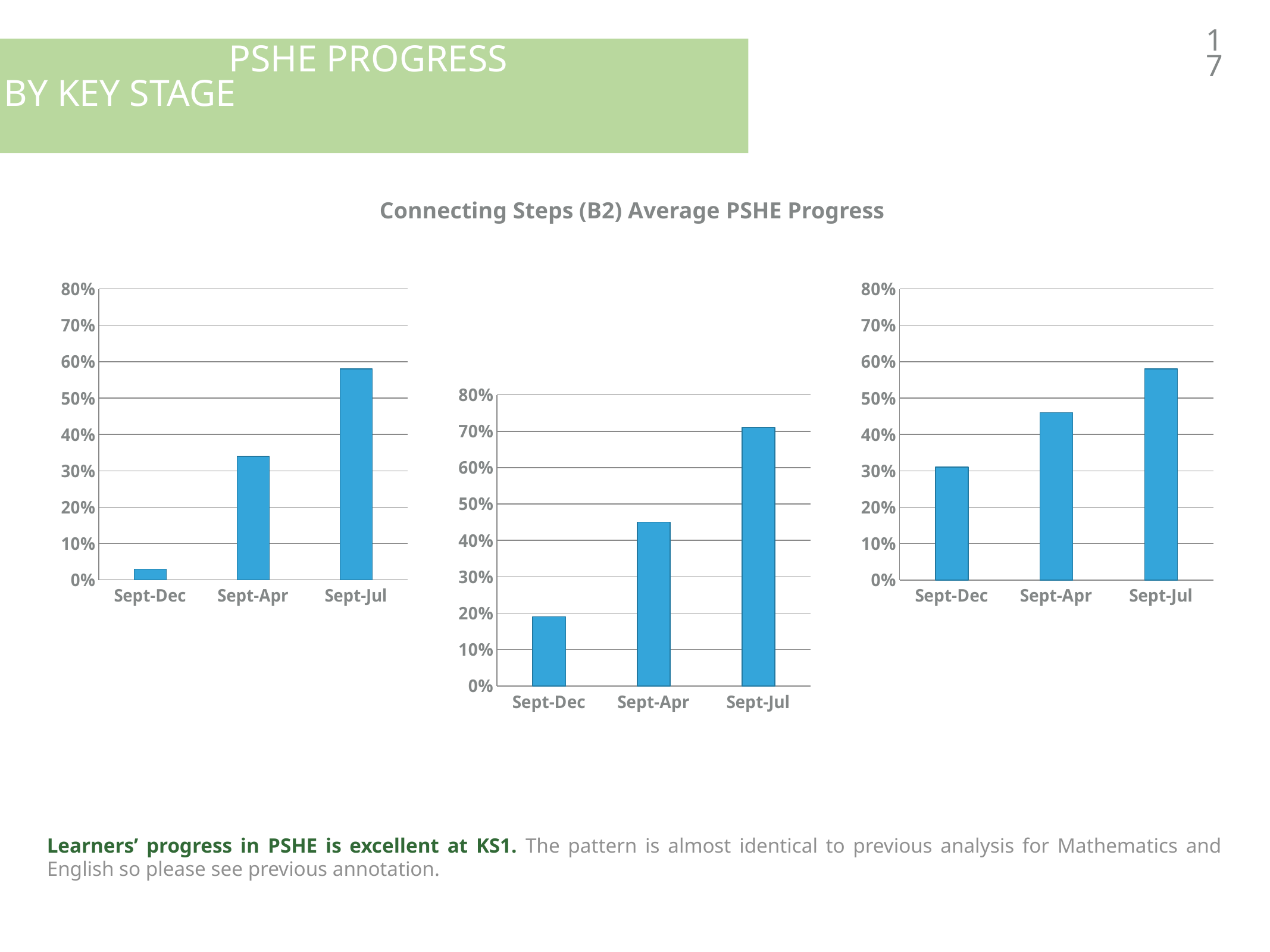
What kind of chart is the middle chart? bar chart In the middle chart, which period has the highest value? Sept-Jul In the right chart, do the values rise or fall from Sept-Dec to Sept-Jul? rise In the left chart, which period has the lowest value? Sept-Dec In the right chart, which is larger, the value for Sept-Apr or the value for Sept-Jul? Sept-Jul In the left chart, which period has the highest value? Sept-Jul How many periods are shown on the x axis of the right chart? 3 In the left chart, is the value for Sept-Jul greater or less than 50%? greater In the left chart, is the value for Sept-Dec greater or less than 10%? less